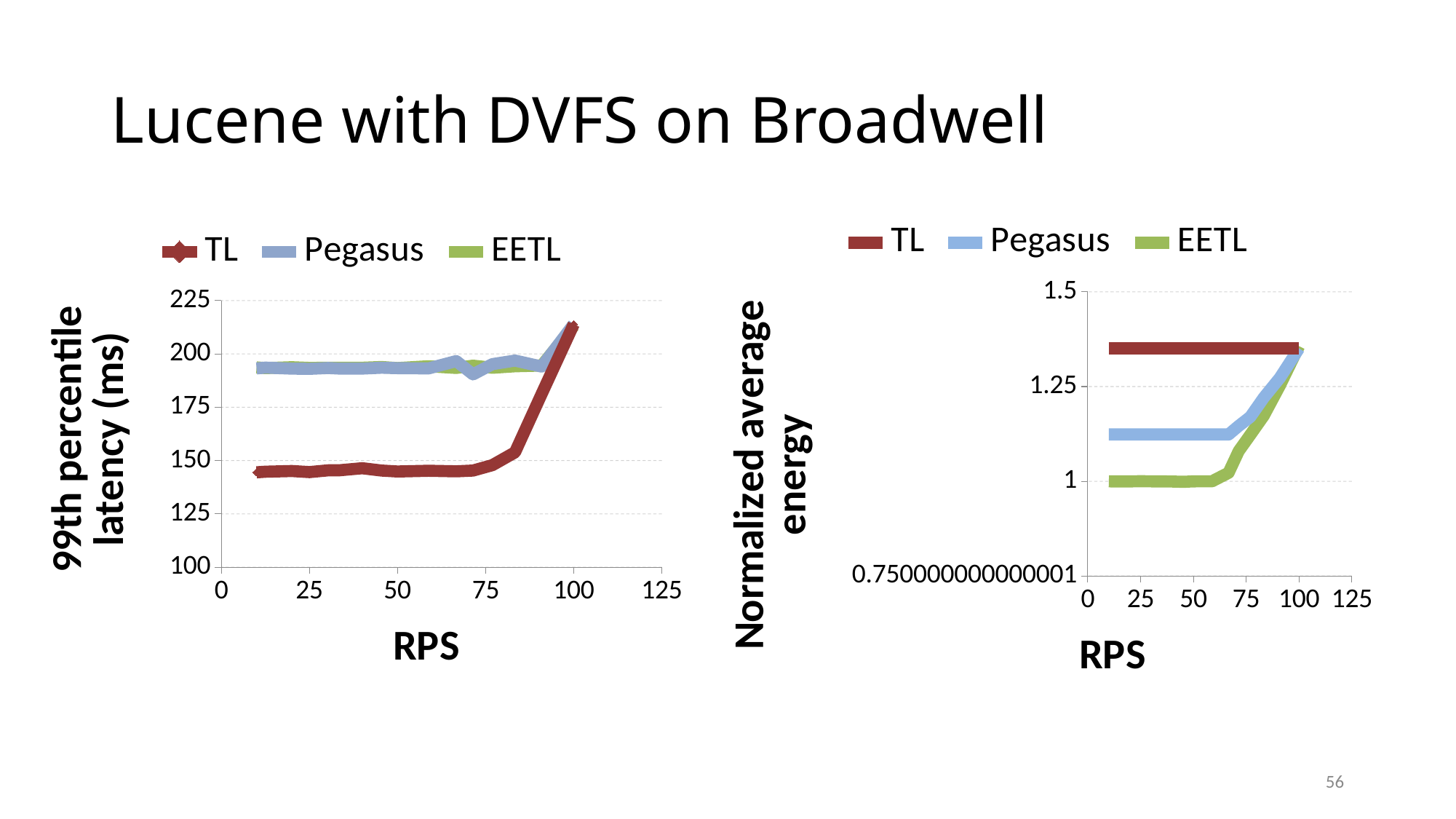
How many series does the legend of the right chart (Normalized average energy) list? 3 What kind of chart is the left chart showing 99th percentile latency? line chart In the left chart (99th percentile latency), is the value for TL at 100 RPS greater or less than 200? greater In the right chart (Normalized average energy), which series has the lowest energy at 25 RPS? EETL What is the y-axis label of the left chart? 99th percentile latency (ms) In the right chart (Normalized average energy), which is larger at 50 RPS, TL or Pegasus? TL In the left chart (99th percentile latency), does the TL series rise or fall as RPS goes from 75 to 100? rise In the left chart (99th percentile latency), is the value for TL at 25 RPS greater or less than 150? less In the right chart (Normalized average energy), is the value for TL at 50 RPS greater or less than 1.25? greater In the left chart (99th percentile latency), which series has the lowest latency at 50 RPS? TL